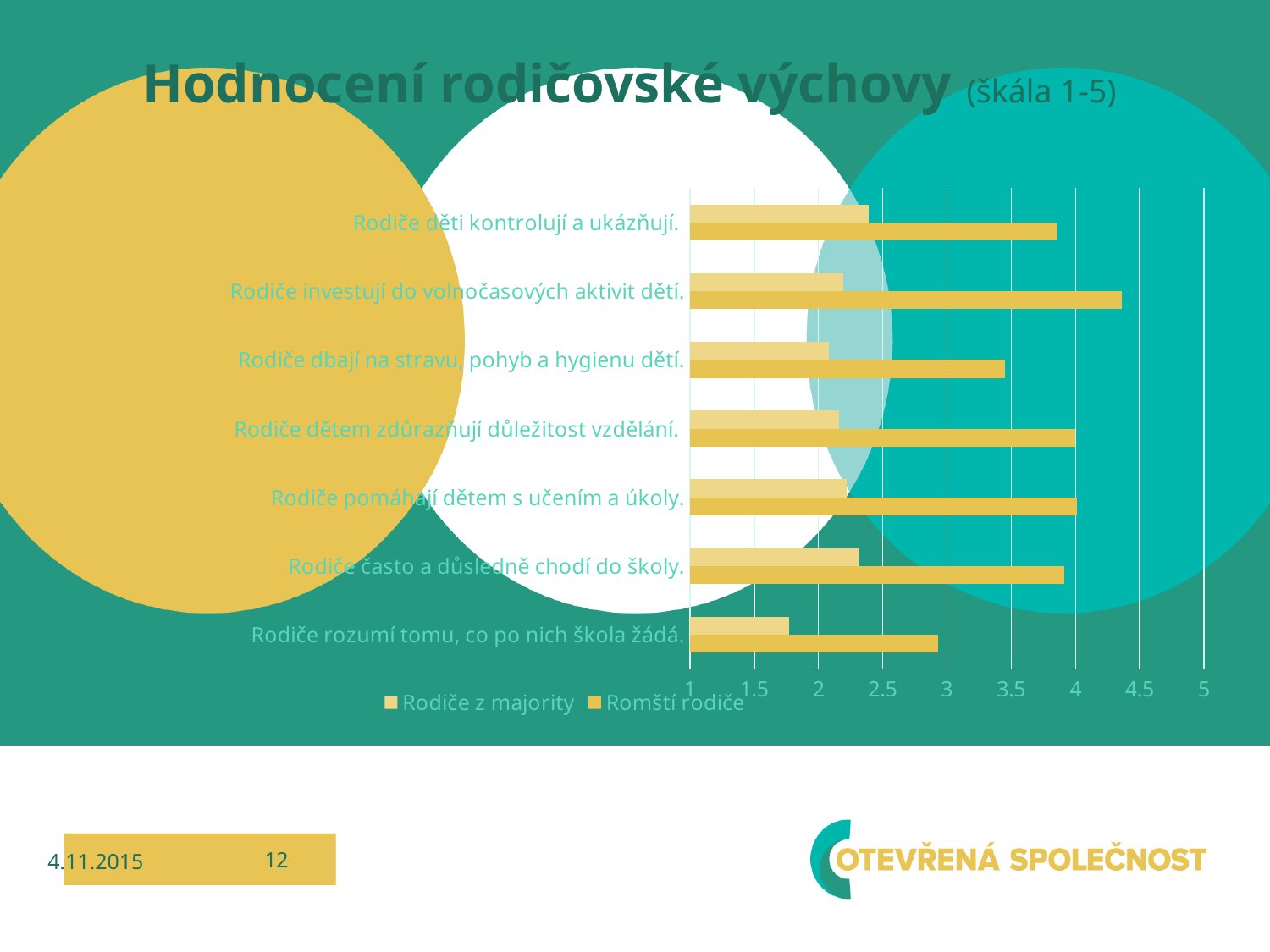
Is the value for Romští rodiče on 'Rodiče investují do volnočasových aktivit dětí.' greater or less than 4? greater How many categories (statements) are plotted on the chart? 7 Is the value for Rodiče z majority on 'Rodiče rozumí tomu, co po nich škola žádá.' greater or less than 2? less For 'Rodiče pomáhají dětem s učením a úkoly.', which series has the larger value, Rodiče z majority or Romští rodiče? Romští rodiče Which category has the lowest value for Romští rodiče? Rodiče rozumí tomu, co po nich škola žádá. What are the two series named in the legend? Rodiče z majority; Romští rodiče Is the value for Romští rodiče on 'Rodiče děti kontrolují a ukázňují.' greater or less than 3.5? greater Which category has the highest value for Romští rodiče? Rodiče investují do volnočasových aktivit dětí. Which category has the lowest value for Rodiče z majority? Rodiče rozumí tomu, co po nich škola žádá. How many series does the legend list? 2 What kind of chart is shown on the slide? bar chart